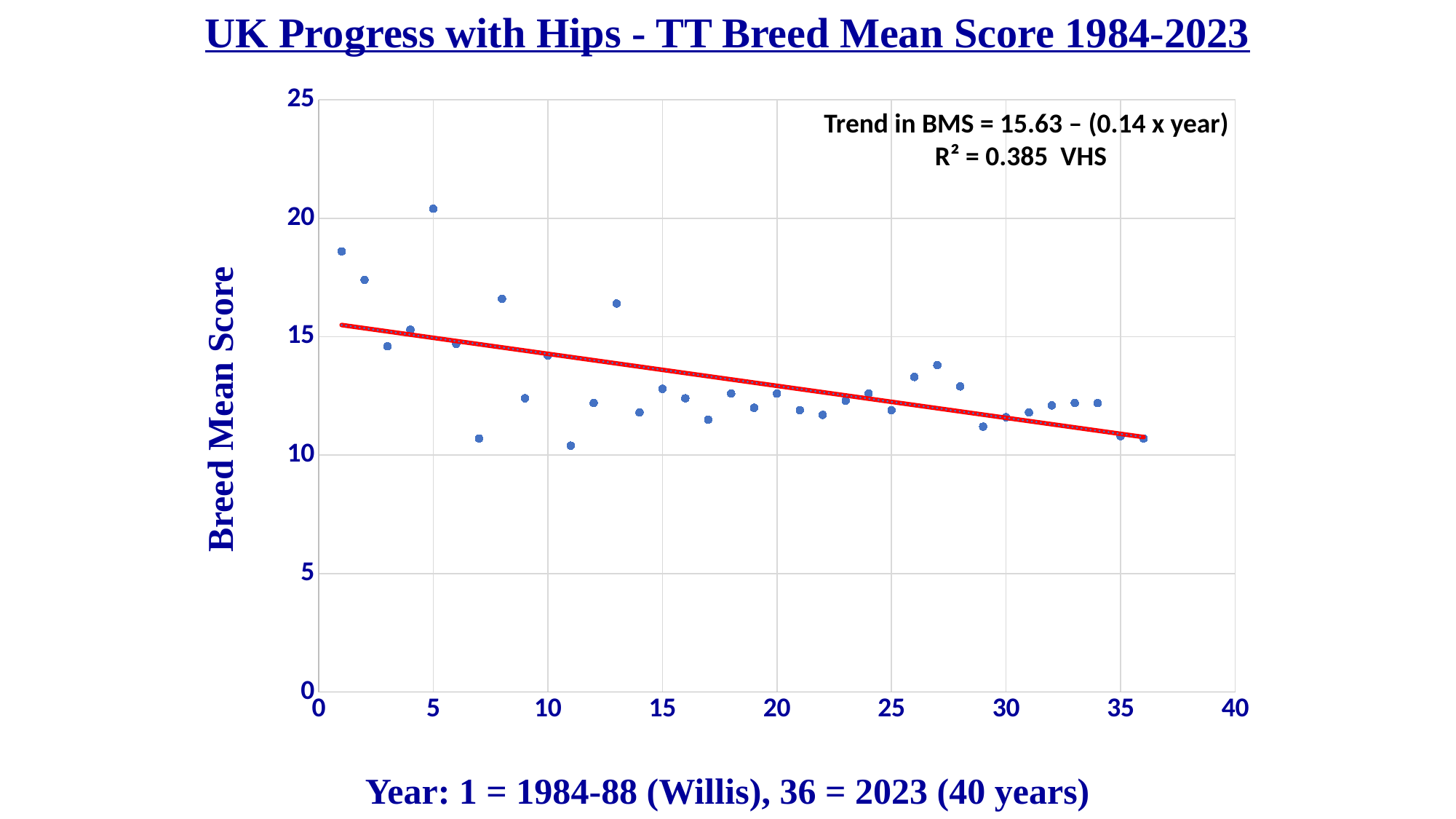
Do the Breed Mean Score values generally rise or fall as the year number increases? fall What kind of chart is shown on the slide? scatter chart Is the Breed Mean Score for year 13 greater or less than 15? greater What is the title of the chart? UK Progress with Hips - TT Breed Mean Score 1984-2023 Which has the larger Breed Mean Score, year 5 or year 7? year 5 At which year number is the Breed Mean Score highest? 5 Is the Breed Mean Score for year 36 greater or less than 15? less Is the Breed Mean Score for year 11 greater or less than 15? less How many data points are plotted on the chart? 36 Which has the larger Breed Mean Score, year 1 or year 36? year 1 What is the R² value shown on the chart? 0.385